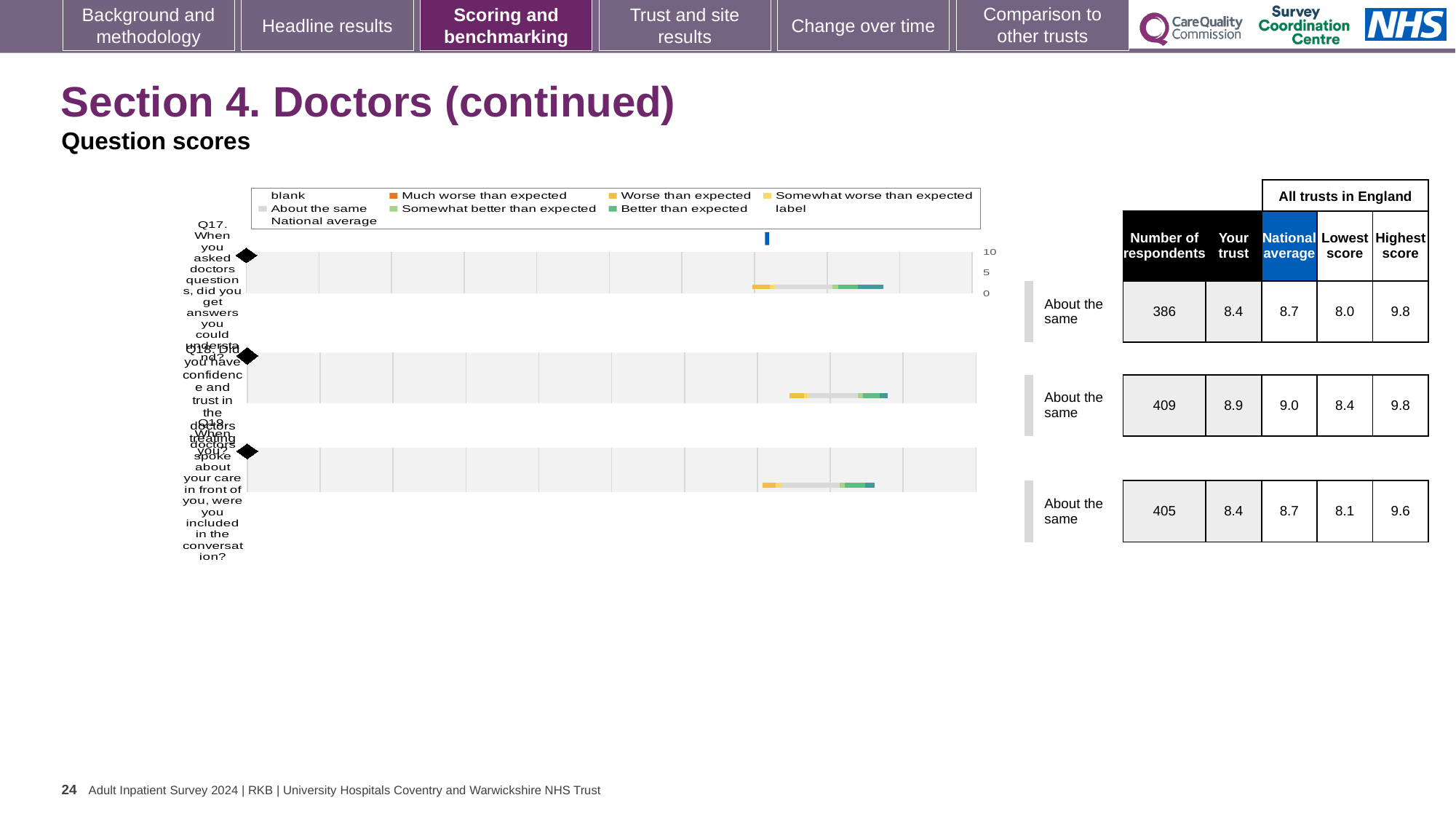
What is the difference between the national average and the 'Your trust' score for Q18? 0.1 How many respondents answered Q19 (When doctors spoke about your care in front of you, were you included in the conversation)? 405 Is the 'Your trust' score for Q18 greater or less than 5 on the chart axis? greater Which question has the highest 'Your trust' score? Q18 What is the lowest score among all trusts in England for Q17? 8.0 What benchmark category is shown next to each of the three question charts? About the same What is the highest score among all trusts in England for Q19? 9.6 For Q17, which is larger: the 'Your trust' score or the national average? National average What is the national average score for Q18 (Did you have confidence and trust in the doctors treating you)? 9.0 What kind of chart is used to show the question scores for Q17, Q18 and Q19? bar chart What is the 'Your trust' score for Q17 (When you asked doctors questions, did you get answers you could understand)? 8.4 How many questions are plotted in the question scores chart? 3